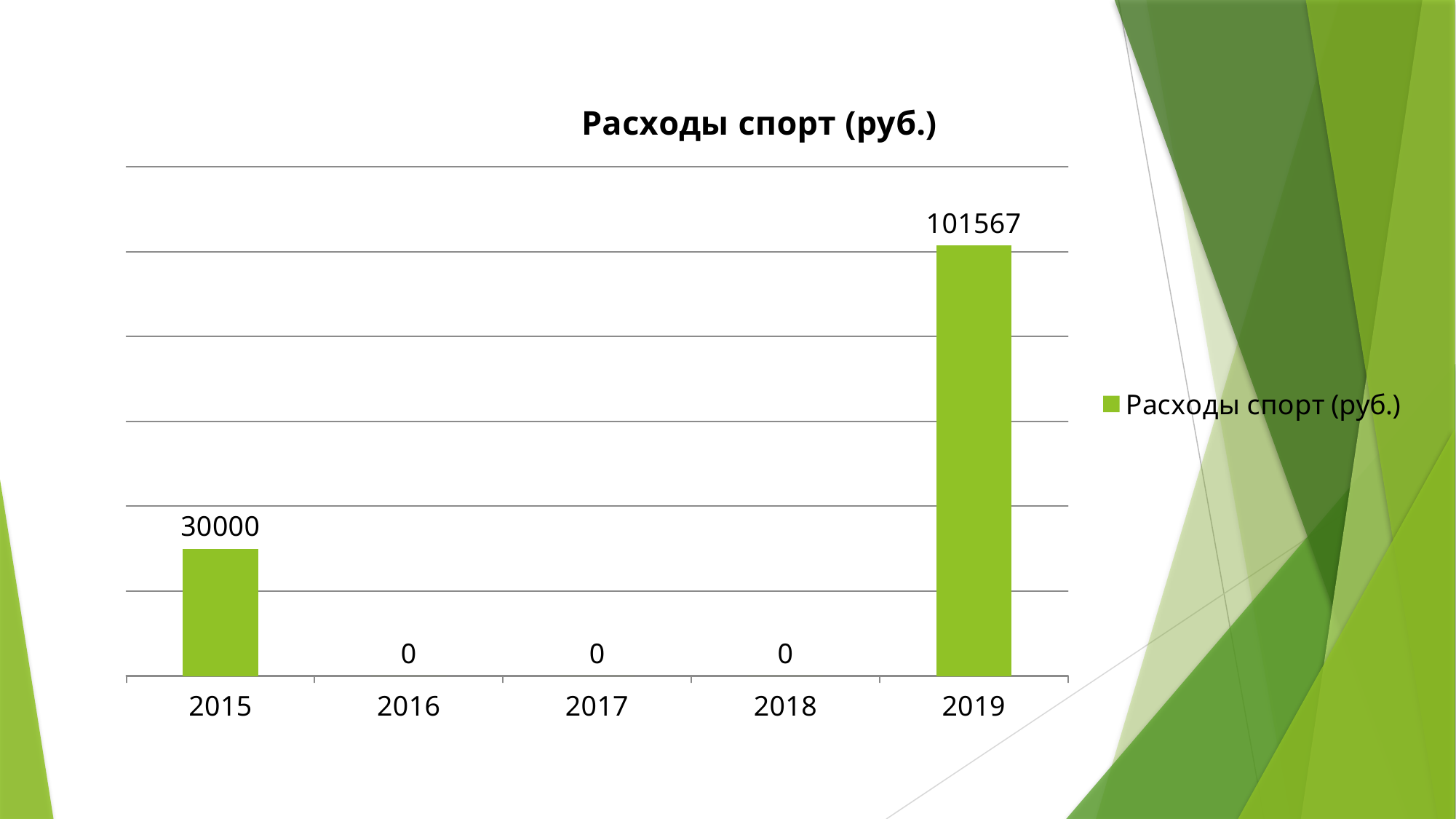
What is the value for 2015? 30000 What is the value for 2017? 0 What colour are the bars? green Which year has the highest value? 2019 Which is larger, the value for 2015 or the value for 2019? 2019 What kind of chart is shown? bar chart What is the title of the chart? Расходы спорт (руб.) How many years have a value of 0? 3 How many years are shown on the x axis? 5 How many series does the legend list? 1 What is the value for 2019? 101567 What is the difference between the values for 2019 and 2015? 71567